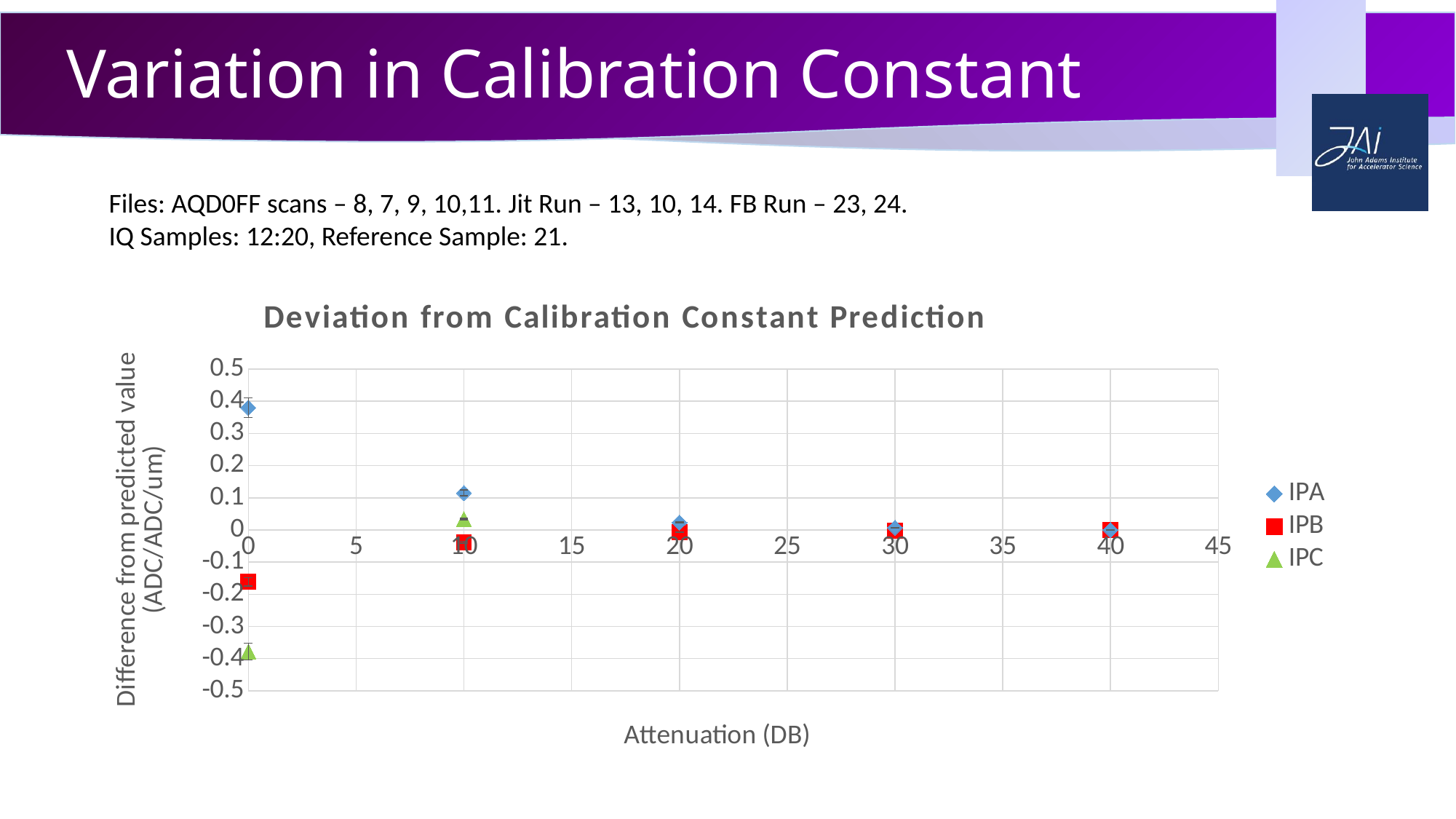
Is the value for IPB at attenuation 0 greater or less than -0.1? less Is the value for IPA at attenuation 0 greater or less than 0.3? greater What is the label of the x axis? Attenuation (DB) Which series has the highest value at attenuation 0? IPA Do the IPA values rise or fall as attenuation increases from 0 to 40? fall How many series does the chart legend list? 3 Which series has the lowest value at attenuation 0? IPC At attenuation 0, which is larger, the value for IPA or the value for IPB? IPA Is the value for IPC at attenuation 0 greater or less than -0.3? less What is the title of the chart? Deviation from Calibration Constant Prediction What kind of chart is shown on the slide? Scatter chart At how many attenuation values are data points plotted? 5